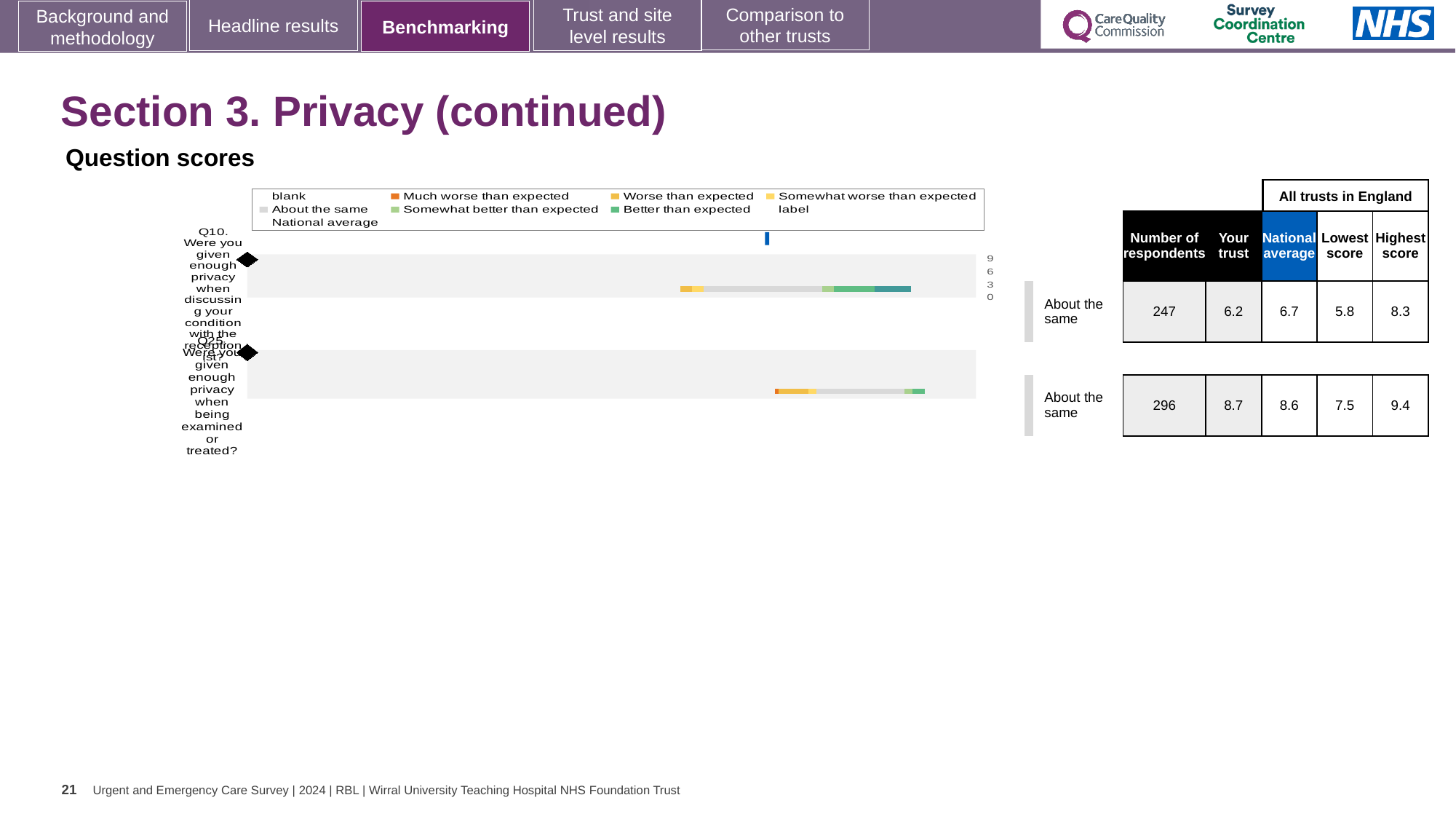
What kind of chart is shown on the slide? bar chart What benchmark category is shown for Q25? About the same What colour does the legend use for 'Much worse than expected'? orange How many more respondents answered Q25 than Q10? 49 What is the 'Your trust' score for Q25 (privacy when being examined or treated)? 8.7 What is the lowest score among all trusts in England for Q25? 7.5 What is the number of respondents for Q10 (privacy when discussing your condition with the receptionist)? 247 What is the national average score for Q10? 6.7 How many survey questions are plotted in the chart? 2 Which question has more respondents, Q10 or Q25? Q25 What is the highest score among all trusts in England for Q10? 8.3 What is the difference between the highest score and the lowest score for Q10? 2.5